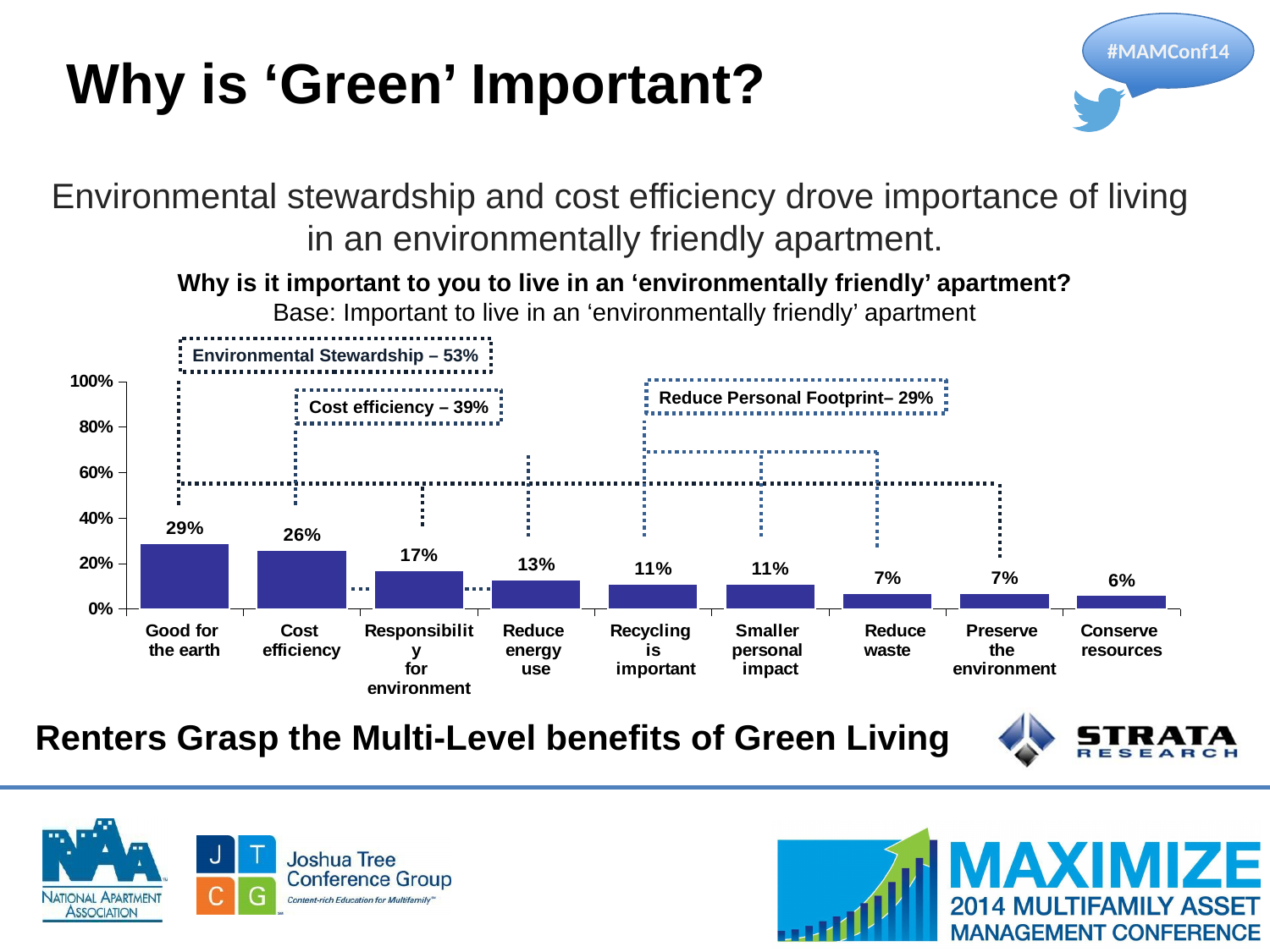
What kind of chart is this? Bar chart How many categories are shown on the x axis? 9 Which category has the highest value? Good for the earth Do the values rise or fall from left to right along the x axis? Fall What percentage of respondents cited 'Good for the earth' as a reason? 29% What is the difference between 'Good for the earth' and 'Cost efficiency'? 3% Which is larger, 'Cost efficiency' or 'Recycling is important'? Cost efficiency Which category has the lowest value? Conserve resources What percentage is shown in the 'Environmental Stewardship' grouping box above the chart? 53% What is the difference between 'Responsibility for environment' and 'Reduce waste'? 10% What is the value for 'Conserve resources'? 6% What is the value for 'Reduce energy use'? 13%